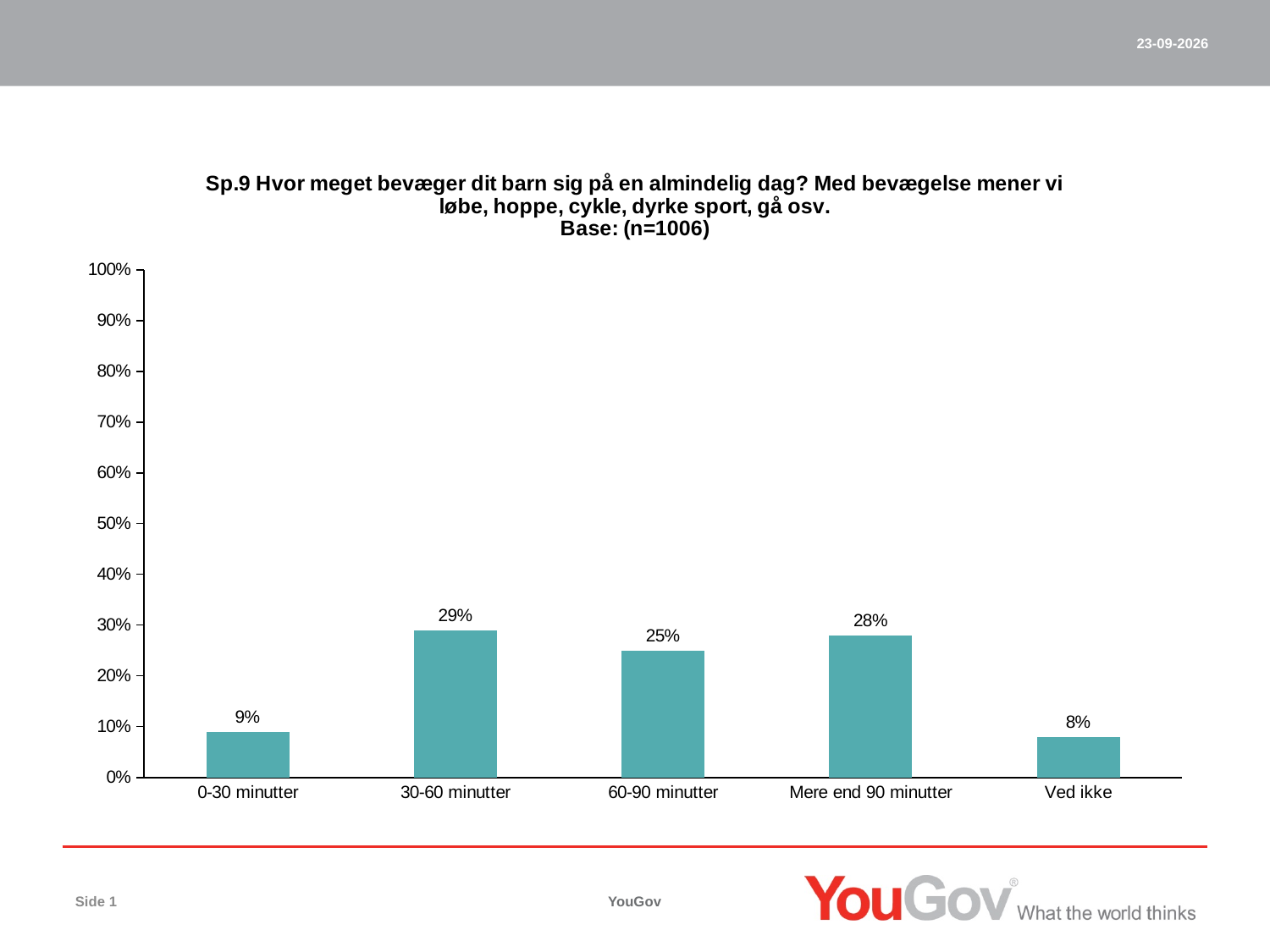
Is the value for 'Mere end 90 minutter' greater or less than 20%? greater What is the base size (n) stated in the chart title? n=1006 Which category has the highest value? 30-60 minutter What is the difference between the values for '30-60 minutter' and '60-90 minutter'? 4% Which category has the lowest value? Ved ikke Which is larger, the value for '60-90 minutter' or the value for 'Mere end 90 minutter'? Mere end 90 minutter What is the value for '0-30 minutter'? 9% What is the value for '30-60 minutter'? 29% What is the highest value shown on the y axis? 100% What is the value for 'Ved ikke'? 8% How many categories are shown on the x axis? 5 What kind of chart is this? bar chart